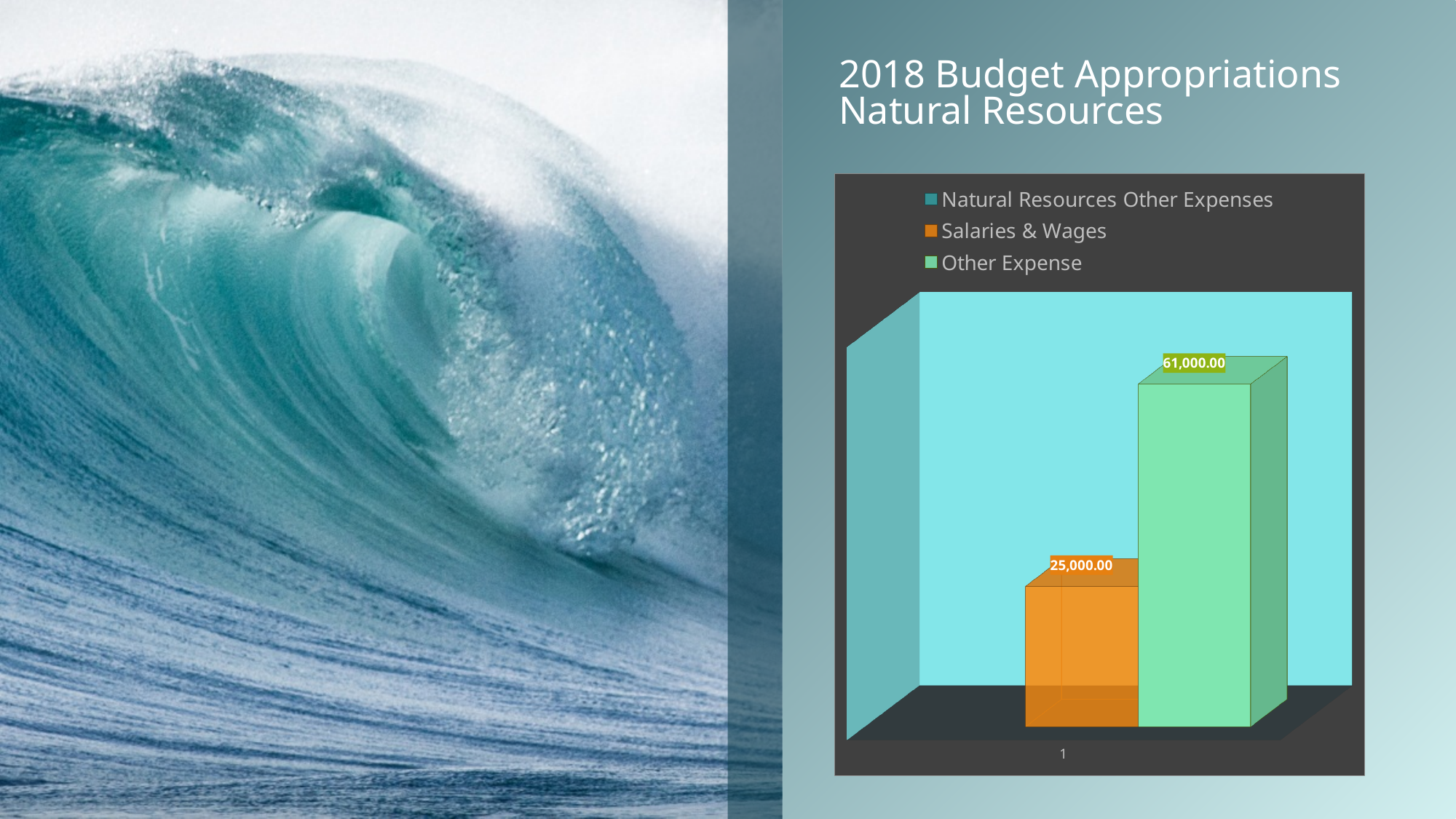
What is the total of the Salaries & Wages and Other Expense values? 86,000.00 What kind of chart is shown on the slide? Bar chart What colour is the Salaries & Wages bar? Orange What is the difference between the Other Expense value and the Salaries & Wages value? 36,000.00 What is the value for Other Expense? 61,000.00 Which series has the highest value shown on the chart? Other Expense How many series does the legend list? 3 Which is larger, Salaries & Wages or Other Expense? Other Expense What is the label on the category axis? 1 What is the value for Salaries & Wages? 25,000.00 What is the title of the slide containing the chart? 2018 Budget Appropriations Natural Resources Which of the two plotted bars is lower, Salaries & Wages or Other Expense? Salaries & Wages